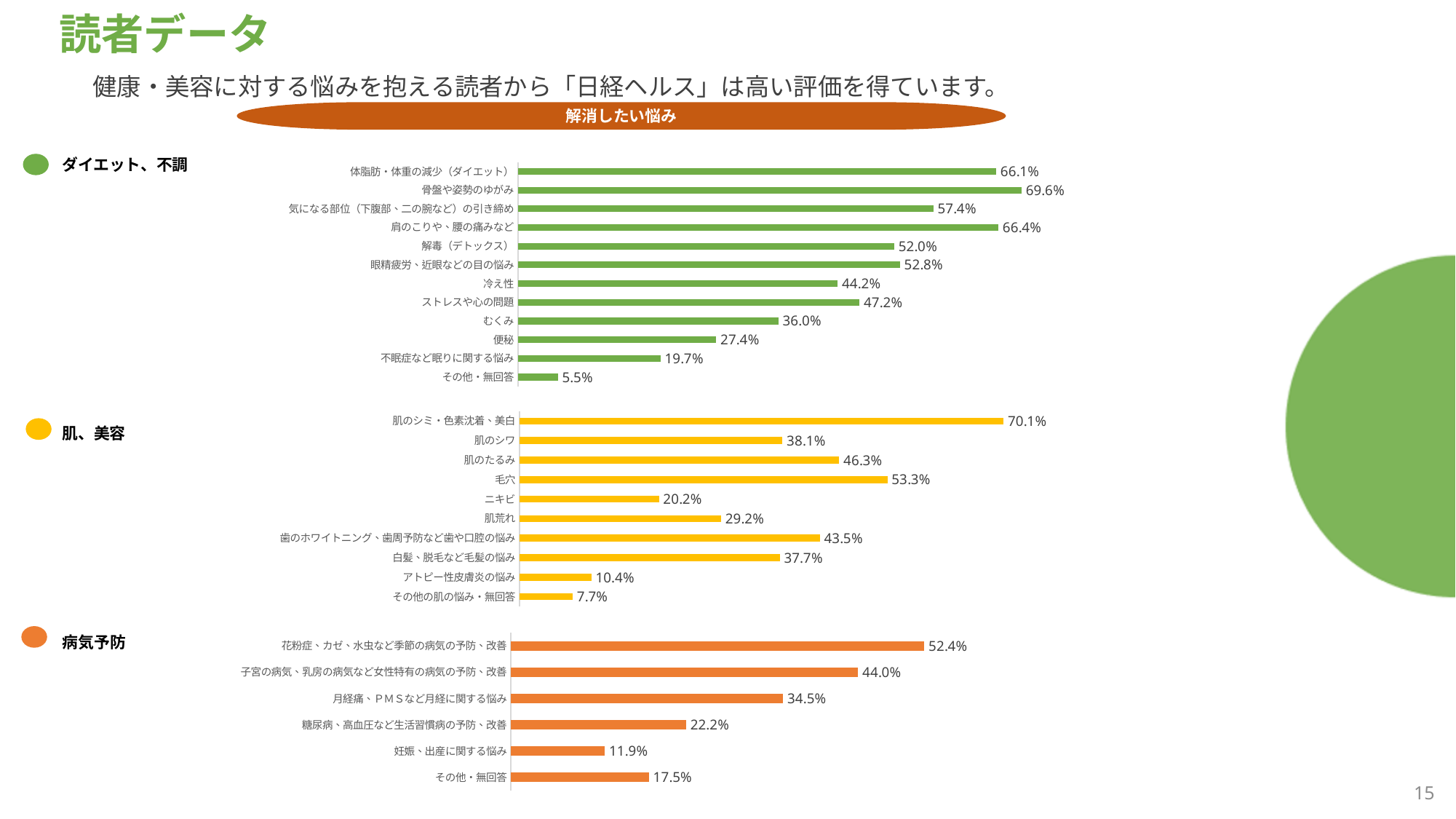
In the 肌、美容 chart, which category has the lowest value? その他の肌の悩み・無回答 In the 肌、美容 chart, what is the value for 毛穴? 53.3% In the 肌、美容 chart, which is larger: 肌のシワ or 白髪、脱毛など毛髪の悩み? 肌のシワ In the 病気予防 chart, what is the value for 月経痛、PMSなど月経に関する悩み? 34.5% In the ダイエット、不調 chart, what is the difference between 体脂肪・体重の減少（ダイエット） and 便秘? 38.7% In the 病気予防 chart, which category has the highest value? 花粉症、カゼ、水虫など季節の病気の予防、改善 How many categories are shown in the ダイエット、不調 chart? 12 How many categories are shown in the 肌、美容 chart? 10 In the 病気予防 chart, what is the difference between 子宮の病気、乳房の病気など女性特有の病気の予防、改善 and 妊娠、出産に関する悩み? 32.1% What type of chart is used for the 病気予防 data? bar chart In the ダイエット、不調 chart, which category has the highest value? 骨盤や姿勢のゆがみ In the ダイエット、不調 chart, what is the value for 骨盤や姿勢のゆがみ? 69.6%